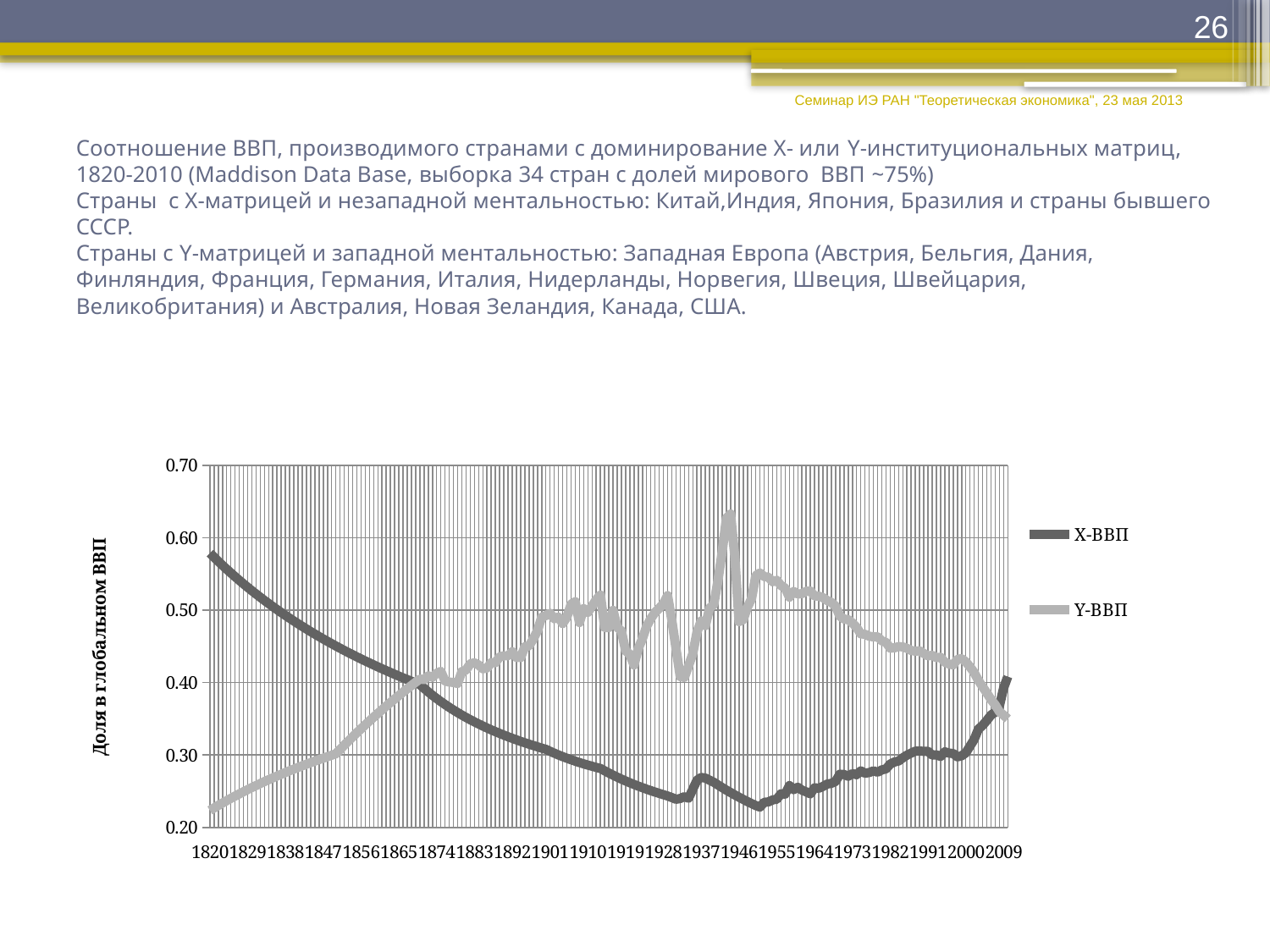
What kind of chart is shown on the slide? line chart Does the X-ВВП line rise or fall between 1820 and 1901? fall Which series has the higher value in 1820, X-ВВП or Y-ВВП? X-ВВП What is the title of the vertical axis of the chart? Доля в глобальном ВВП Is the highest value reached by the Y-ВВП line greater or less than 0.60? greater What are the two series named in the chart legend? X-ВВП and Y-ВВП Is the value of X-ВВП in 1820 greater or less than 0.50? greater Is the value of Y-ВВП in 1820 greater or less than 0.30? less Which series has the higher value in 1955, X-ВВП or Y-ВВП? Y-ВВП How many series does the legend of the chart list? 2 Does the Y-ВВП line rise or fall between 1820 and 1901? rise